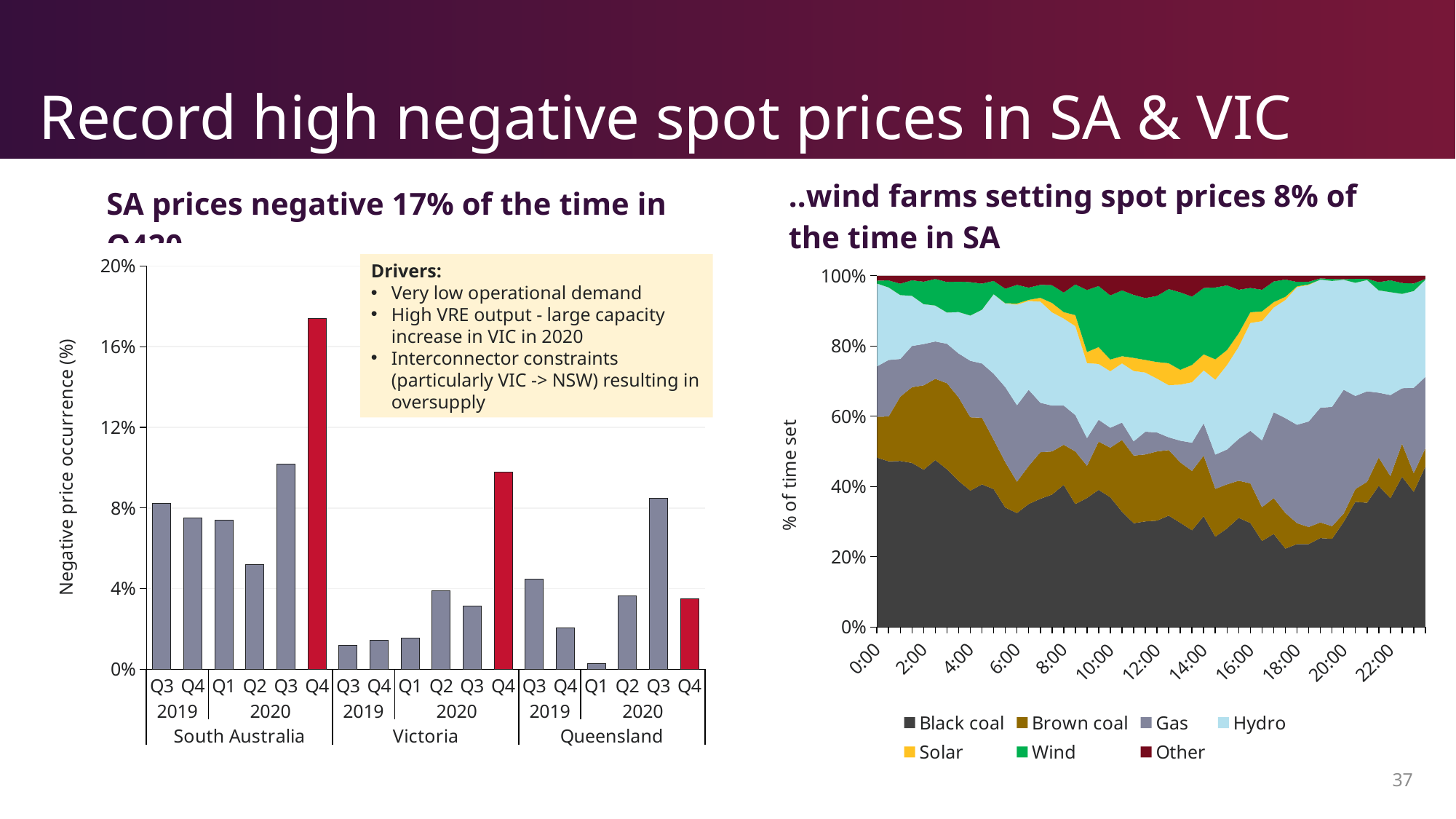
On the left chart, which region and quarter has the lowest negative price occurrence? Queensland, Q1 2020 On the left chart, which is larger: the Q4 2020 value for South Australia or the Q4 2020 value for Victoria? South Australia What type of chart is the left chart showing negative price occurrence? bar chart On the left chart, which region and quarter has the highest negative price occurrence? South Australia, Q4 2020 On the left chart, how many bars are plotted in total? 18 On the right chart, how many series does the legend list? 7 On the right chart, which series forms the bottom layer of the stacked area? Black coal On the left chart, is the value for Queensland Q1 2020 greater or less than 4%? less What is the y-axis label of the right chart? % of time set On the left chart, is the value for Victoria Q4 2020 greater or less than 8%? greater On the left chart, is the value for South Australia Q4 2020 greater or less than 16%? greater On the left chart, how many regions are shown on the x axis? 3